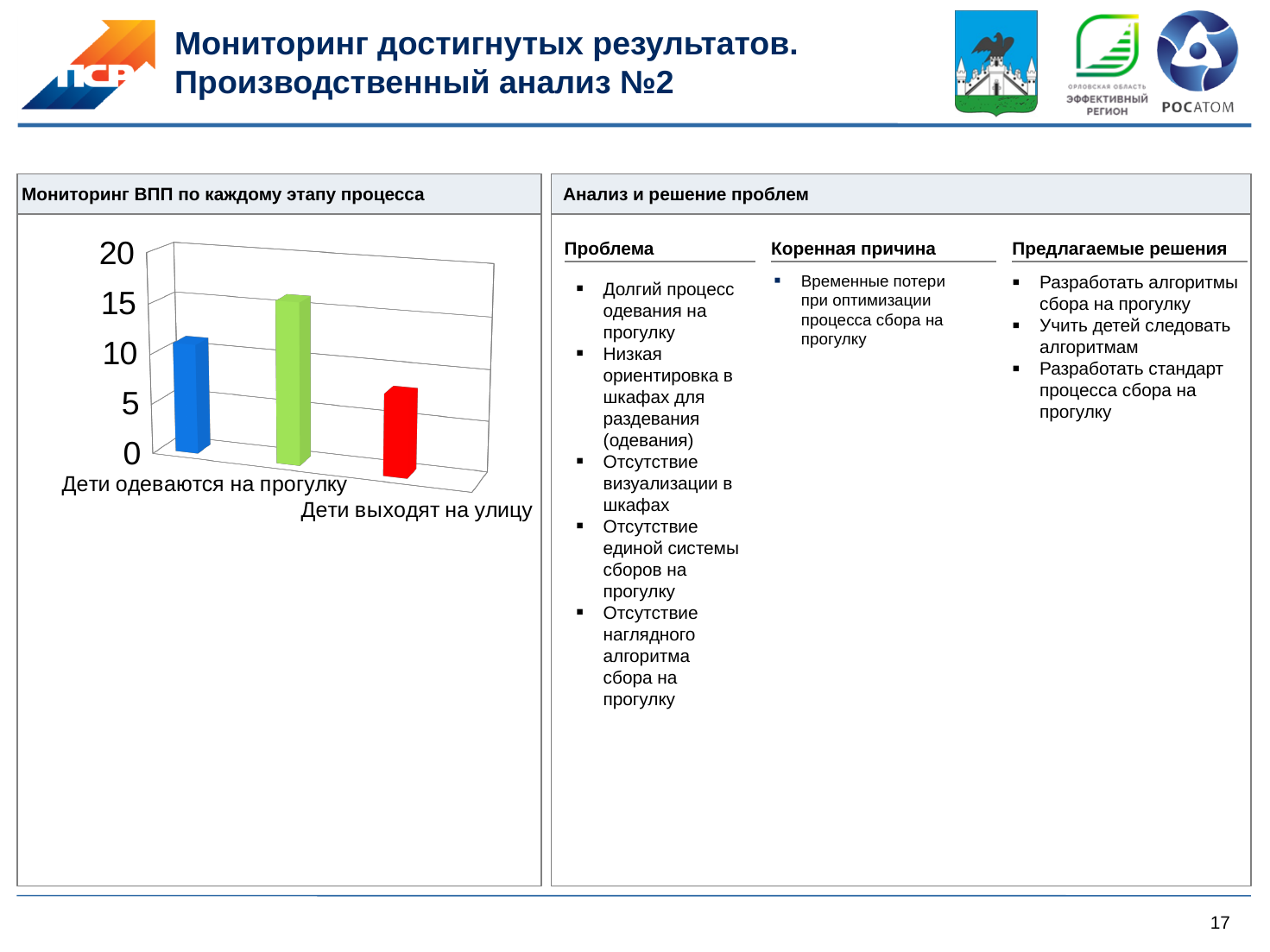
What kind of chart is shown in the 'Мониторинг ВПП по каждому этапу процесса' panel? bar chart Is the value of the red bar greater or less than 10? less Is the value of the green bar greater or less than 20? less Is the value of the blue bar greater or less than 5? greater What is the title of the panel containing the chart? Мониторинг ВПП по каждому этапу процесса What is the highest tick value shown on the chart's vertical axis? 20 How many bars are plotted in the chart? 3 Which is taller in the chart, the green bar or the blue bar? the green bar Which bar in the chart is the shortest? the red bar Which is taller in the chart, the blue bar or the red bar? the blue bar Which bar in the chart is the tallest? the green bar